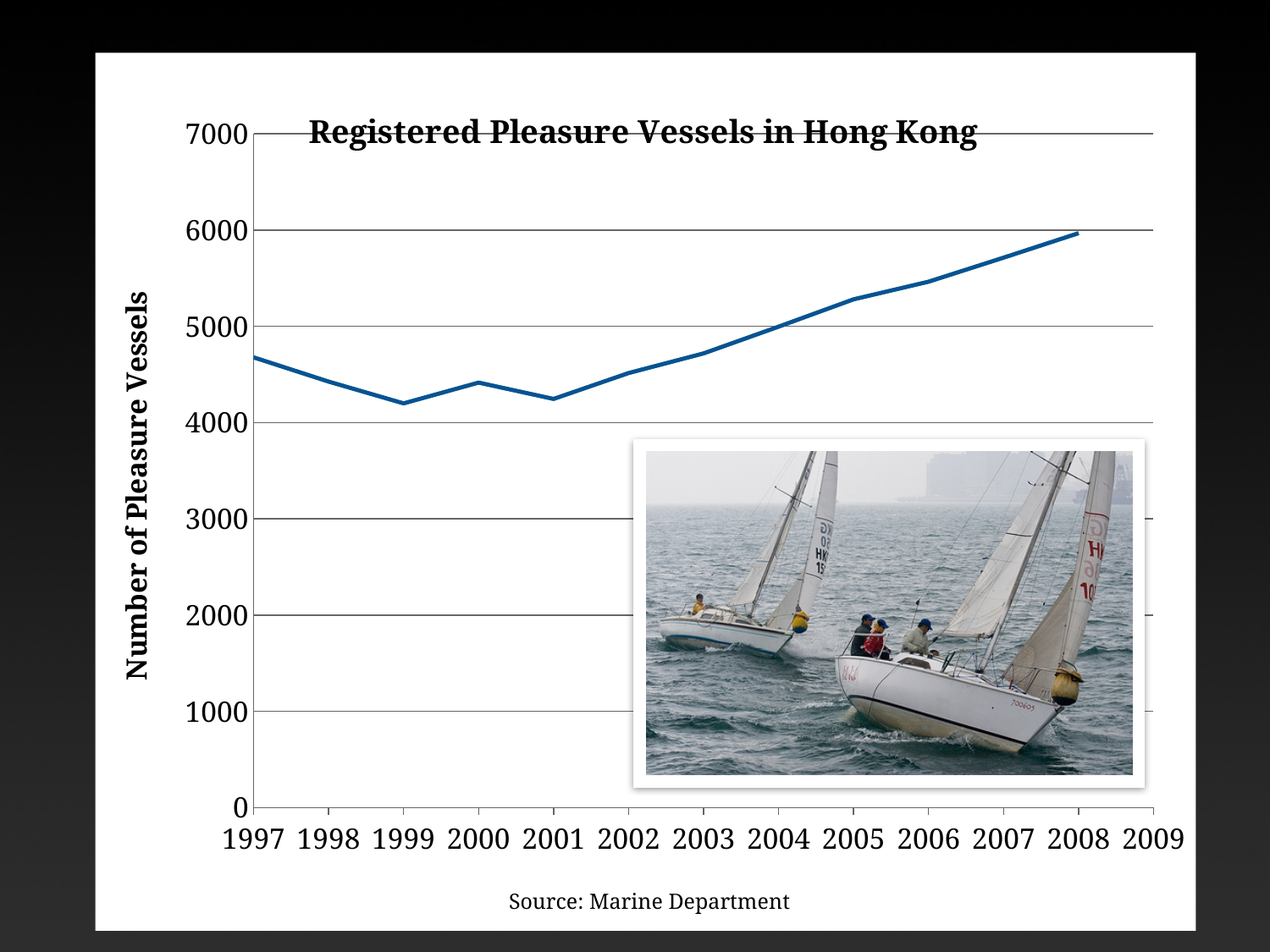
What is the title of the chart? Registered Pleasure Vessels in Hong Kong How many years have a data point plotted on the line? 12 Is the value for 2001 greater or less than 4000? greater What is the label on the vertical axis of the chart? Number of Pleasure Vessels Is the value for 2005 greater or less than 5000? greater What kind of chart is shown on the slide? line chart In which year is the number of registered pleasure vessels highest? 2008 In which year is the number of registered pleasure vessels lowest? 1999 Which year has a larger number of registered pleasure vessels, 1997 or 2007? 2007 Do the values generally rise or fall from 2001 to 2008? rise Is the value for 1999 greater or less than 5000? less